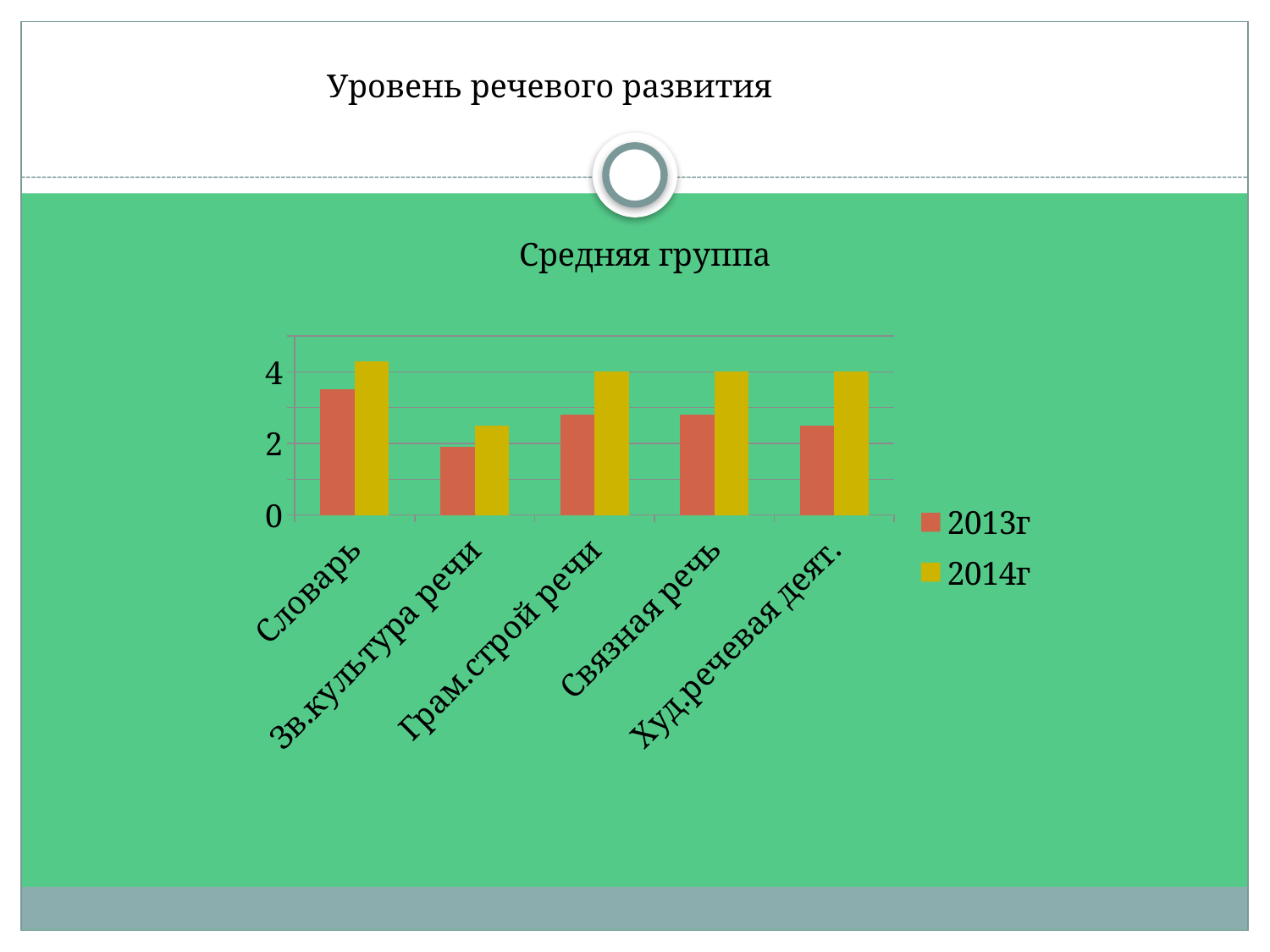
Is the value for Словарь in 2013г greater or less than 2? greater Which category has the lowest value for 2013г? Зв.культура речи For Связная речь, which series has the larger value, 2013г or 2014г? 2014г How many categories are shown on the x axis? 5 What are the two legend entries of the chart? 2013г and 2014г Is the value for Словарь in 2014г greater or less than 4? greater How many series does the legend list? 2 What type of chart is shown on the slide? bar chart What is the title of the chart? Средняя группа Which category has the highest value for 2013г? Словарь Which category has the lowest value for 2014г? Зв.культура речи